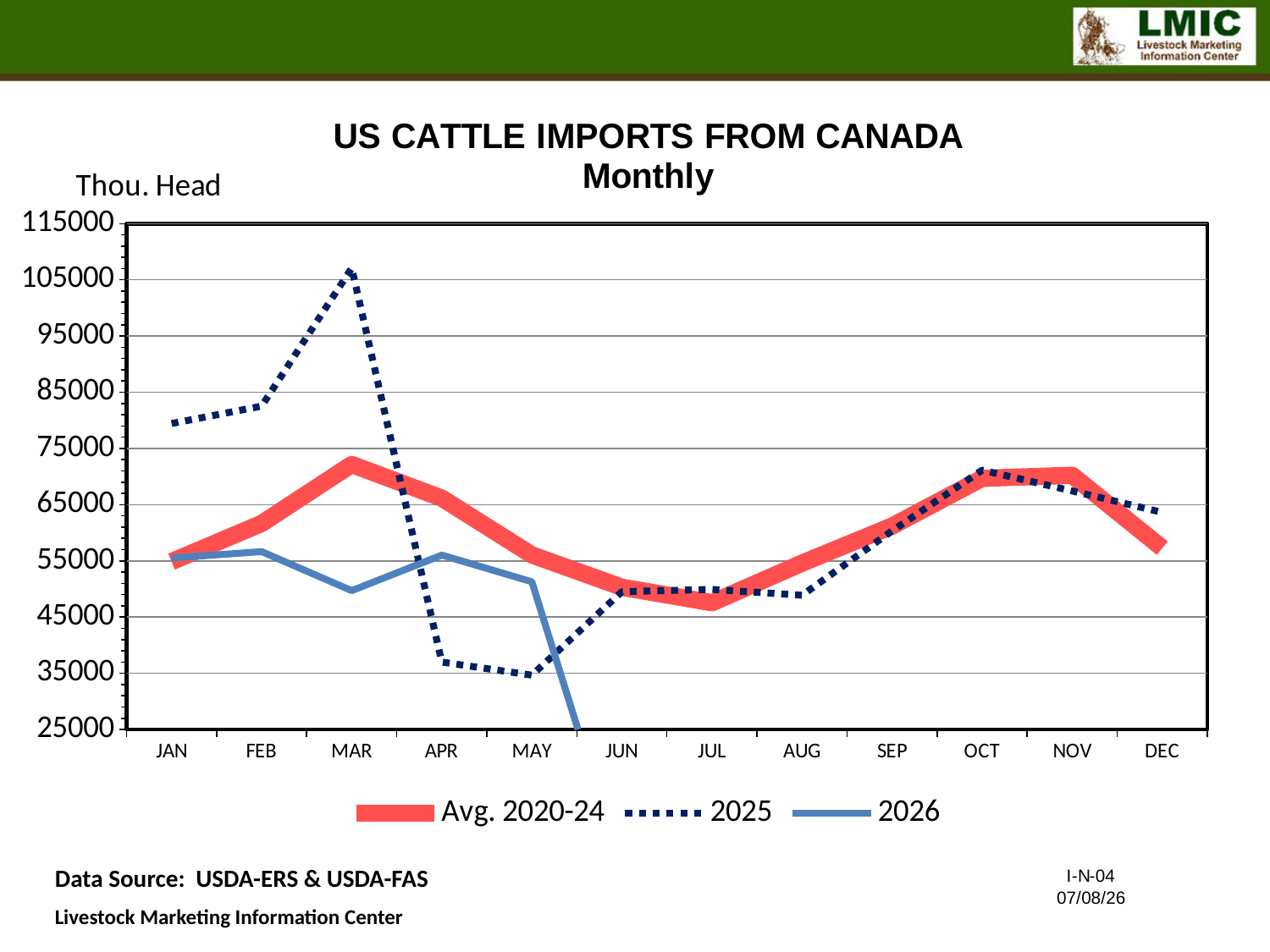
How many months are shown along the x axis? 12 What kind of chart is shown on the slide? line chart In APR, which series is higher: 2025 or Avg. 2020-24? Avg. 2020-24 In which month is the Avg. 2020-24 series at its lowest? JUL How many series does the legend list? 3 Does the 2025 series rise or fall from MAR to MAY? fall In which month does the 2025 series reach its highest value? MAR Is the 2026 value for MAR greater or less than 55000? less Is the 2025 value for JAN greater or less than 75000? greater Is the Avg. 2020-24 value for MAR greater or less than 65000? greater What unit label is shown above the y axis? Thou. Head